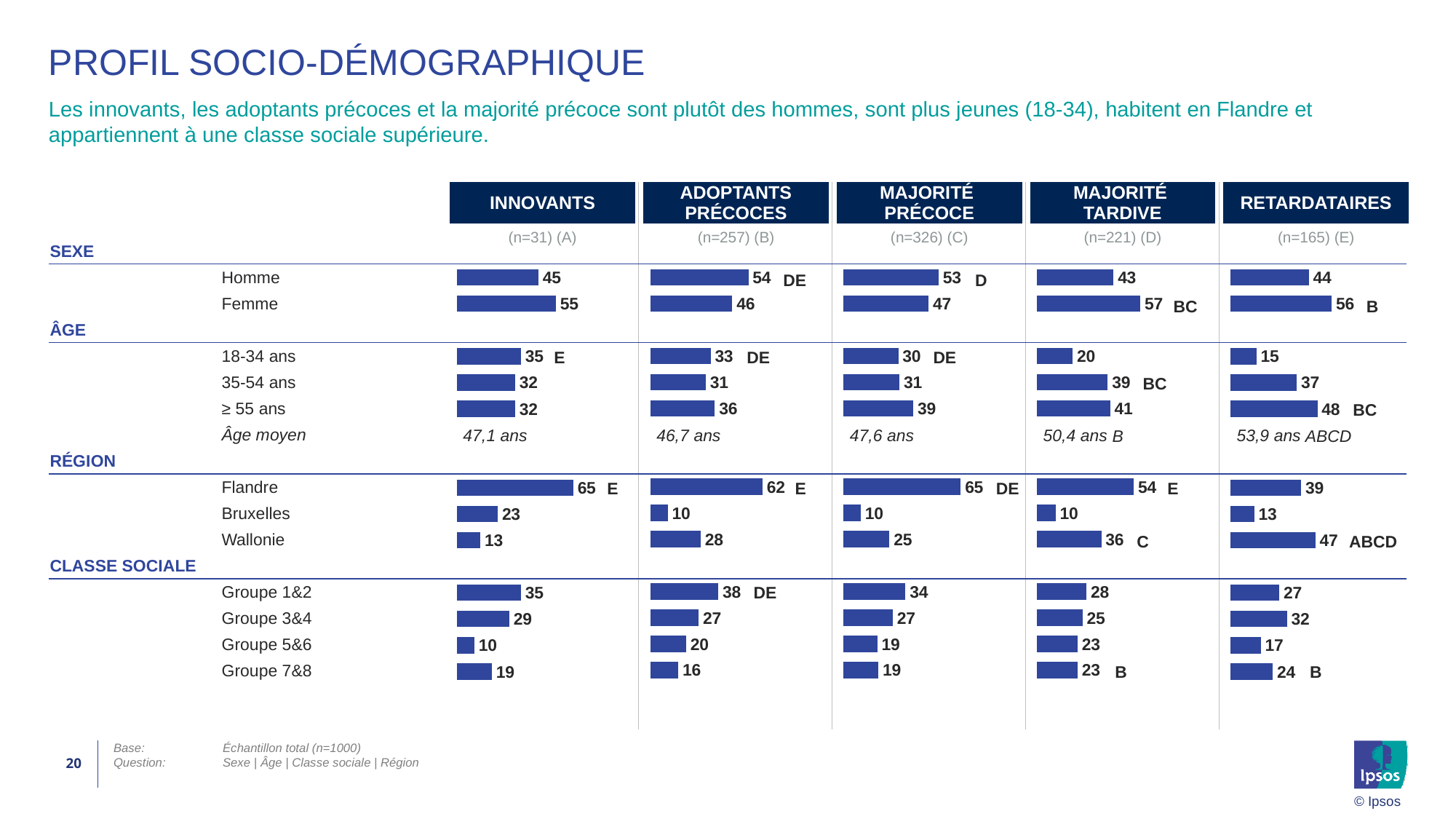
How many classe sociale groups are shown in each column? 4 In the ADOPTANTS PRÉCOCES column, which région has the highest value? Flandre In the INNOVANTS column, what is the value for Flandre? 65 In the RETARDATAIRES column, what is the value for Wallonie? 47 In the RETARDATAIRES column, do the values rise or fall from 18-34 ans to ≥ 55 ans? Rise In the MAJORITÉ TARDIVE column, what is the difference between the values for Flandre and Wallonie? 18 In the MAJORITÉ TARDIVE column, what is the value for Femme? 57 In the RETARDATAIRES column, what is the difference between the values for Femme and Homme? 12 In the INNOVANTS column, which classe sociale group has the lowest value? Groupe 5&6 In the MAJORITÉ PRÉCOCE column, which is larger, the value for 18-34 ans or the value for ≥ 55 ans? ≥ 55 ans What is the âge moyen shown for the RETARDATAIRES column? 53,9 ans What kind of chart is used to show the values in each column? Bar chart